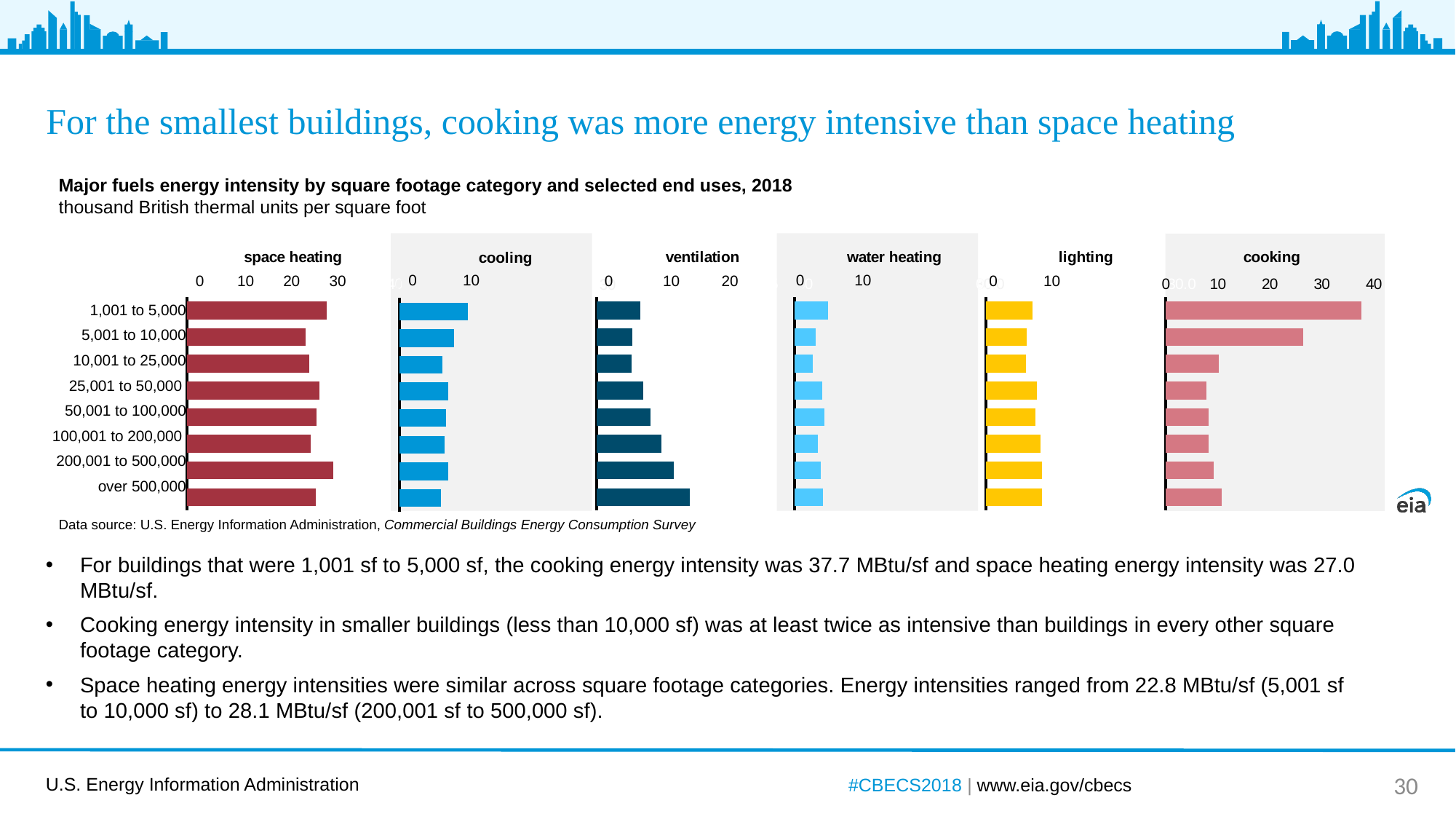
In the space heating panel, what is the energy intensity for buildings 1,001 to 5,000 square feet? 27.0 MBtu/sf In the water heating panel, is the value for 1,001 to 5,000 greater or less than 10? less In the ventilation panel, do the values generally rise or fall as the square footage category increases from 1,001 to 5,000 to over 500,000? rise In the ventilation panel, which square footage category has the highest energy intensity? over 500,000 In the cooking panel, which square footage category has the highest energy intensity? 1,001 to 5,000 In the cooking panel, what is the energy intensity for buildings 1,001 to 5,000 square feet? 37.7 MBtu/sf In the cooling panel, which square footage category has the highest energy intensity? 1,001 to 5,000 How many square footage categories are shown in each panel? 8 For buildings 1,001 to 5,000 square feet, how much higher is the cooking energy intensity than the space heating energy intensity? 10.7 MBtu/sf What kind of chart is used in the space heating panel? bar chart In the cooking panel, is the value for 1,001 to 5,000 greater or less than 30? greater How many end-use panels are shown on the slide? 6